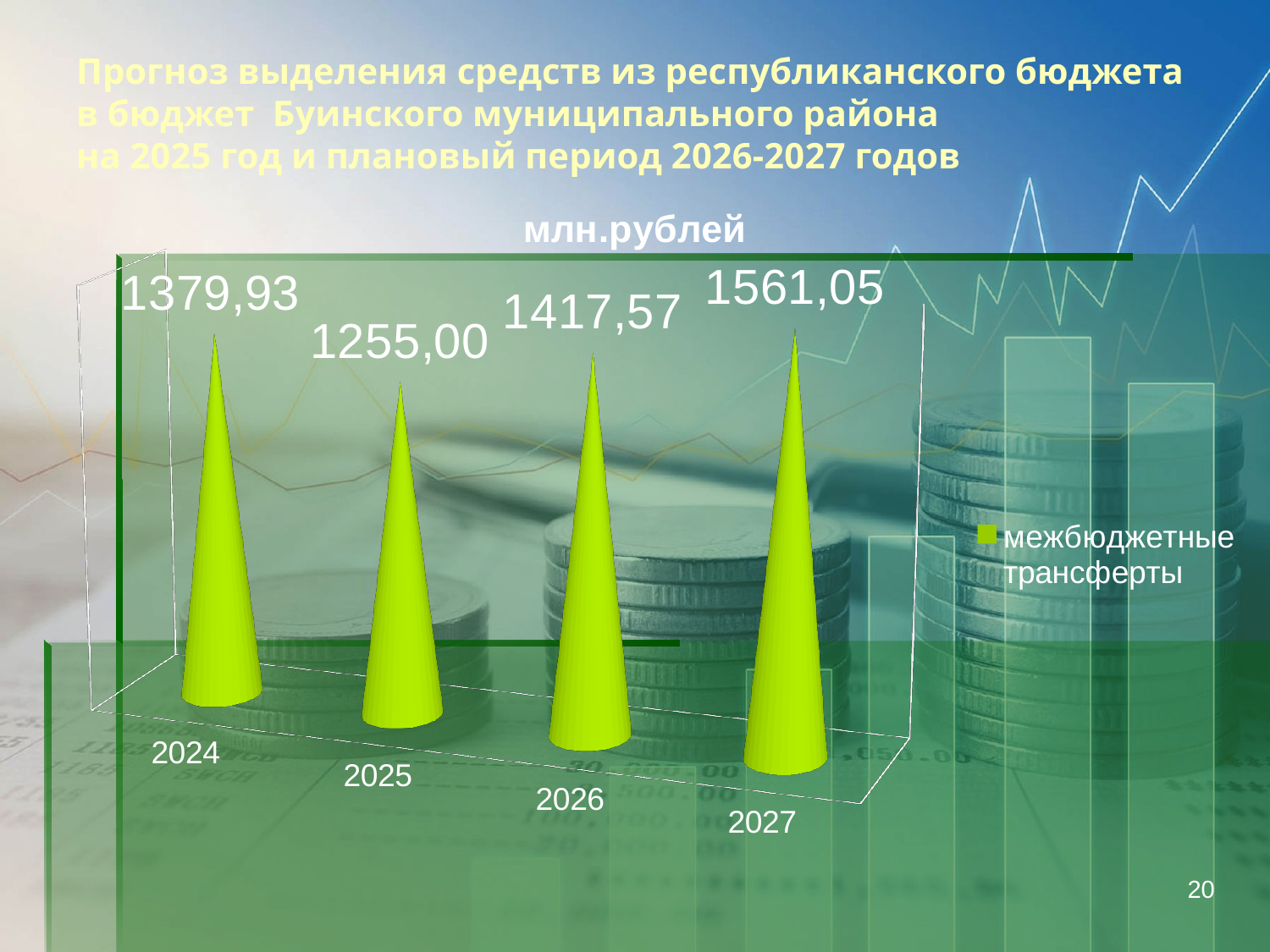
What is the difference between the values for 2027 and 2025? 306,05 What is the name of the series shown in the legend? межбюджетные трансферты What is the value for 2026? 1417,57 Which year has the highest value? 2027 What is the value for 2024? 1379,93 What is the value for 2027? 1561,05 How many years are shown on the x axis? 4 Which year has the lowest value? 2025 What is the difference between the values for 2024 and 2025? 124,93 What is the value for 2025? 1255,00 Which is larger, the value for 2024 or the value for 2026? 2026 How many series does the legend list? 1